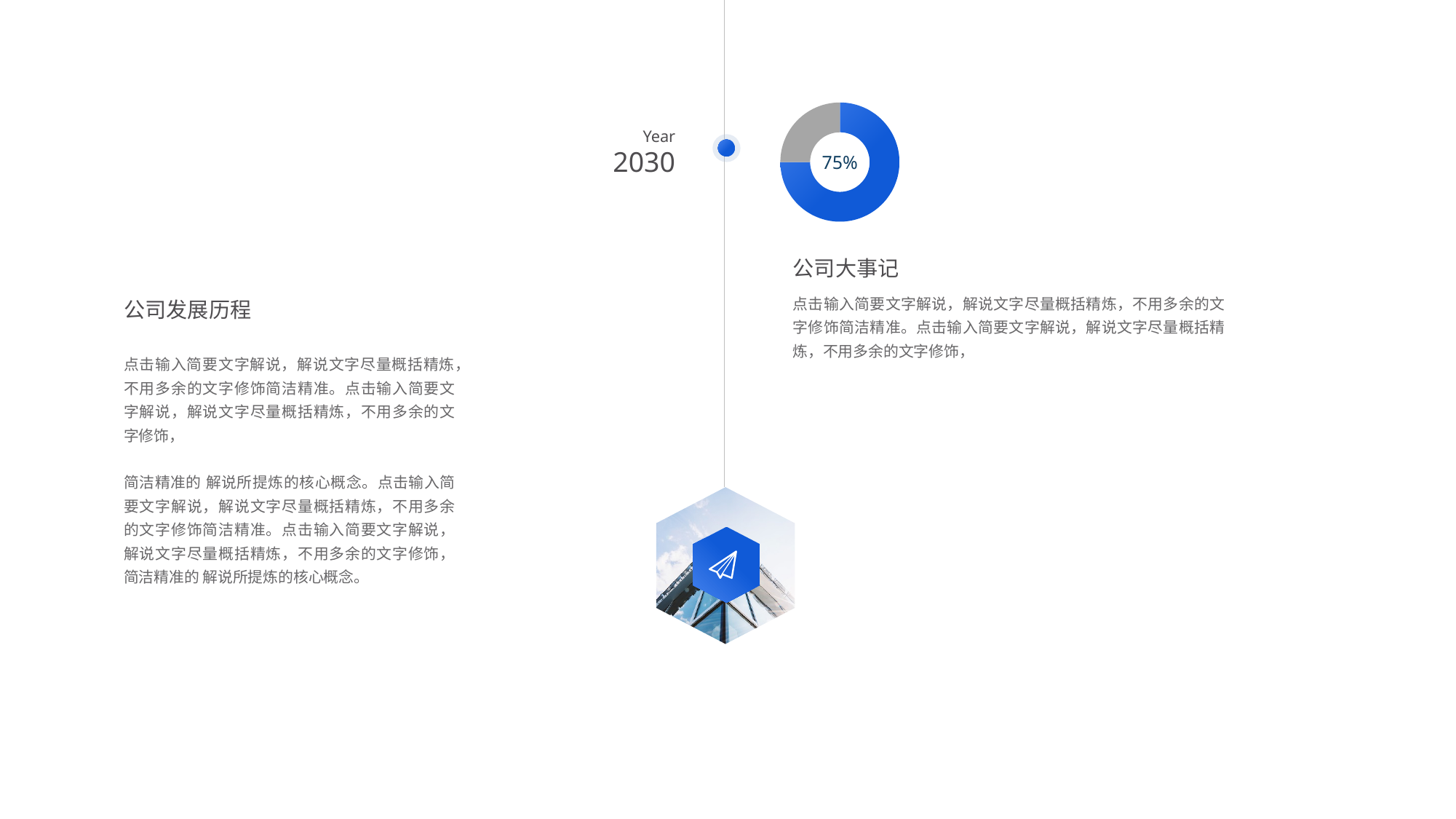
How many segments does the donut chart have? 2 Is the blue segment of the donut chart greater or less than 50% of the whole? greater Is the gray segment of the donut chart greater or less than 50% of the whole? less What share of the donut chart does the gray segment represent? 25% What year label appears next to the donut chart on the timeline? 2030 What percentage is printed in the centre of the donut chart? 75% Which segment of the donut chart is larger, the blue one or the gray one? Blue What kind of chart is shown on the slide? Donut chart What share of the donut chart does the blue segment represent? 75% What colour is the larger segment of the donut chart? Blue